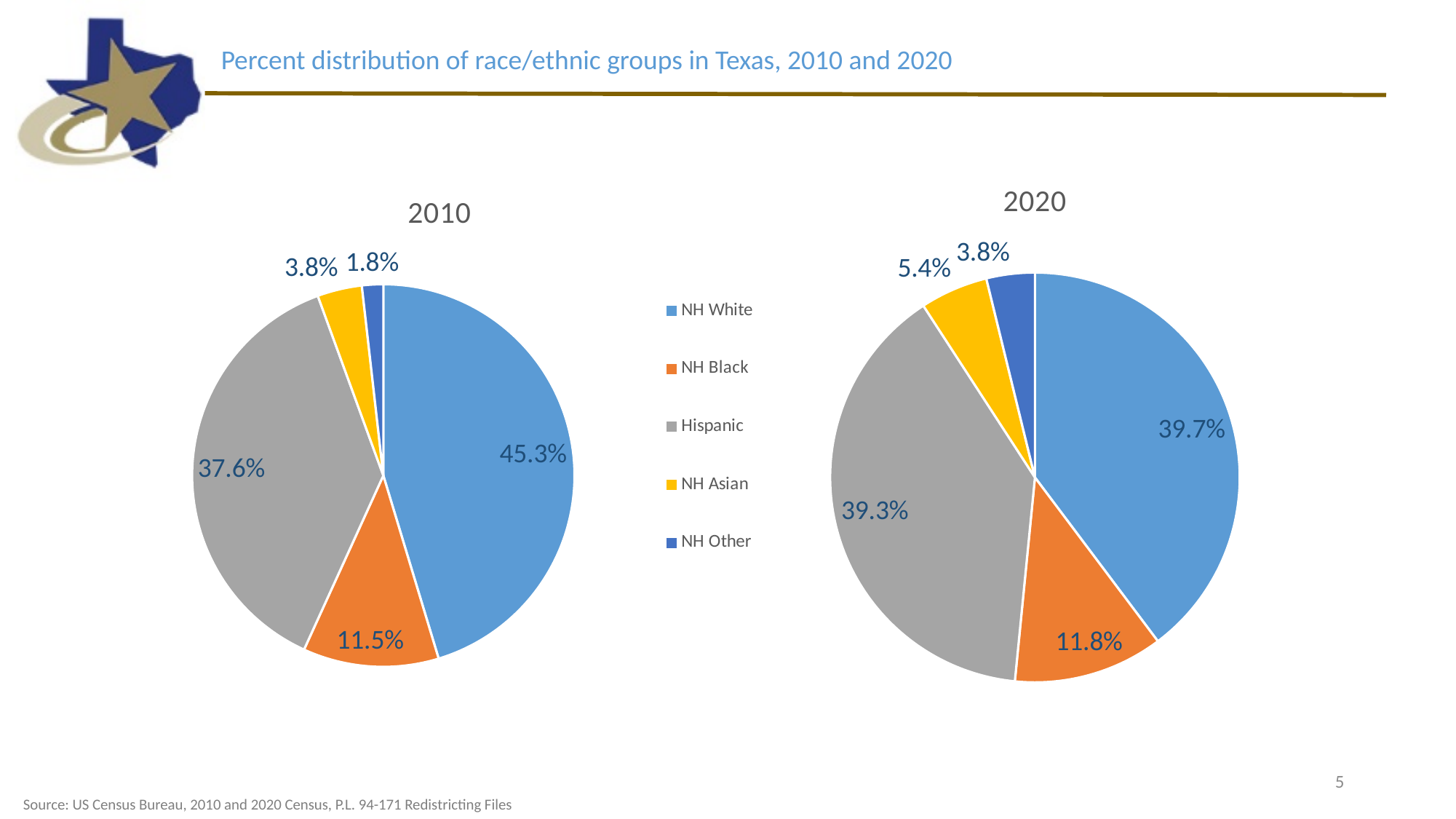
In the 2010 pie chart, what percentage is shown for NH Black? 11.5% Which colour represents Hispanic in the legend? Gray How many groups are shown in each pie chart? 5 In the 2010 pie chart, what percentage is shown for NH White? 45.3% In the 2020 pie chart, what percentage is shown for Hispanic? 39.3% In the 2010 pie chart, which group has the largest share? NH White What type of chart is used on this slide? Pie chart What is the difference between the NH White share in 2010 and in 2020? 5.6% In the 2020 pie chart, is the share for NH Black larger or smaller than the share for NH Asian? larger In the 2020 pie chart, what percentage is shown for NH Asian? 5.4% In the 2010 pie chart, which group has the smallest share? NH Other In the 2020 pie chart, which group has the largest share? NH White